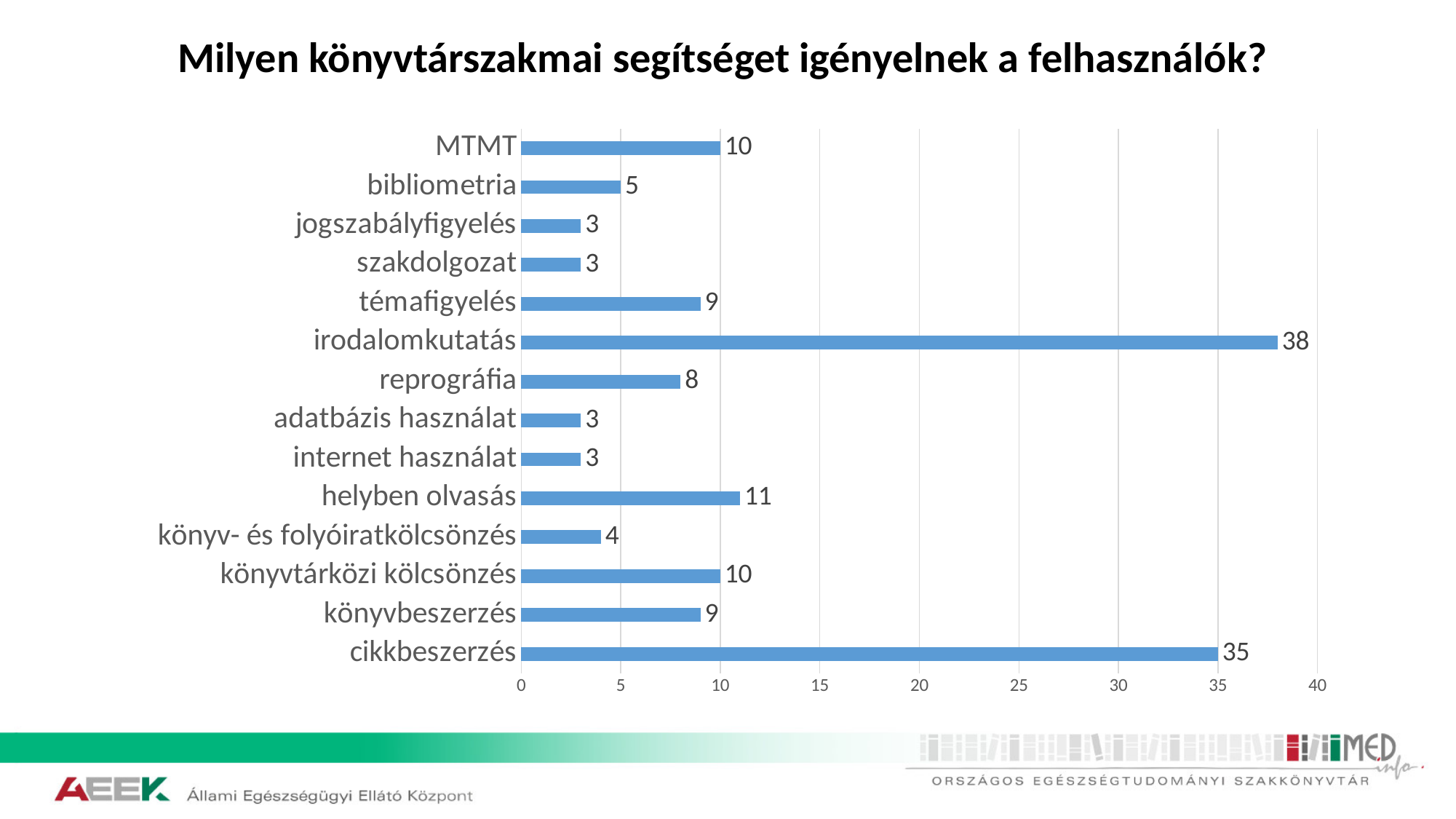
What is the value for bibliometria? 5 Which is larger, the value for MTMT or the value for témafigyelés? MTMT Which category has the highest value? irodalomkutatás What is the value for irodalomkutatás? 38 What is the value for helyben olvasás? 11 What kind of chart is shown on the slide? bar chart What is the title of the slide? Milyen könyvtárszakmai segítséget igényelnek a felhasználók? What is the value for könyv- és folyóiratkölcsönzés? 4 What is the value for cikkbeszerzés? 35 How many categories are shown in the chart? 14 What is the difference between the values for irodalomkutatás and cikkbeszerzés? 3 What is the difference between the values for helyben olvasás and reprográfia? 3